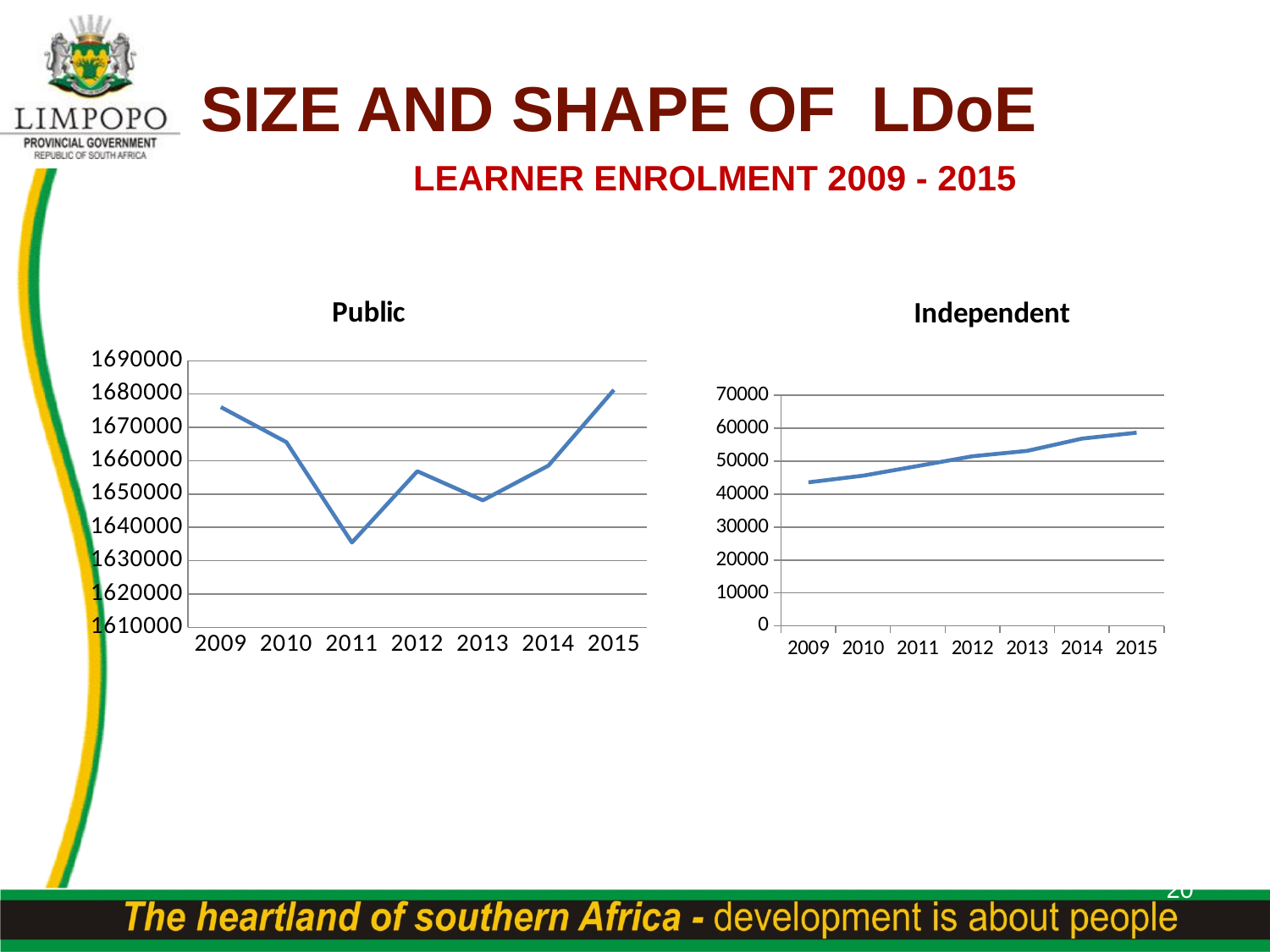
How many years are plotted in the Independent chart? 7 In the Public chart, which year has the highest enrolment? 2015 What kind of chart is the Public chart? line chart In the Independent chart, which year has the highest value? 2015 In the Independent chart, is the value for 2015 greater or less than 60000? less In the Public chart, is the value for 2013 greater or less than 1650000? less In the Public chart, which year has the lowest enrolment? 2011 In the Independent chart, is the value for 2009 greater or less than 40000? greater In the Independent chart, do the values rise or fall from 2009 to 2015? rise In the Public chart, which is larger, the value for 2010 or the value for 2011? 2010